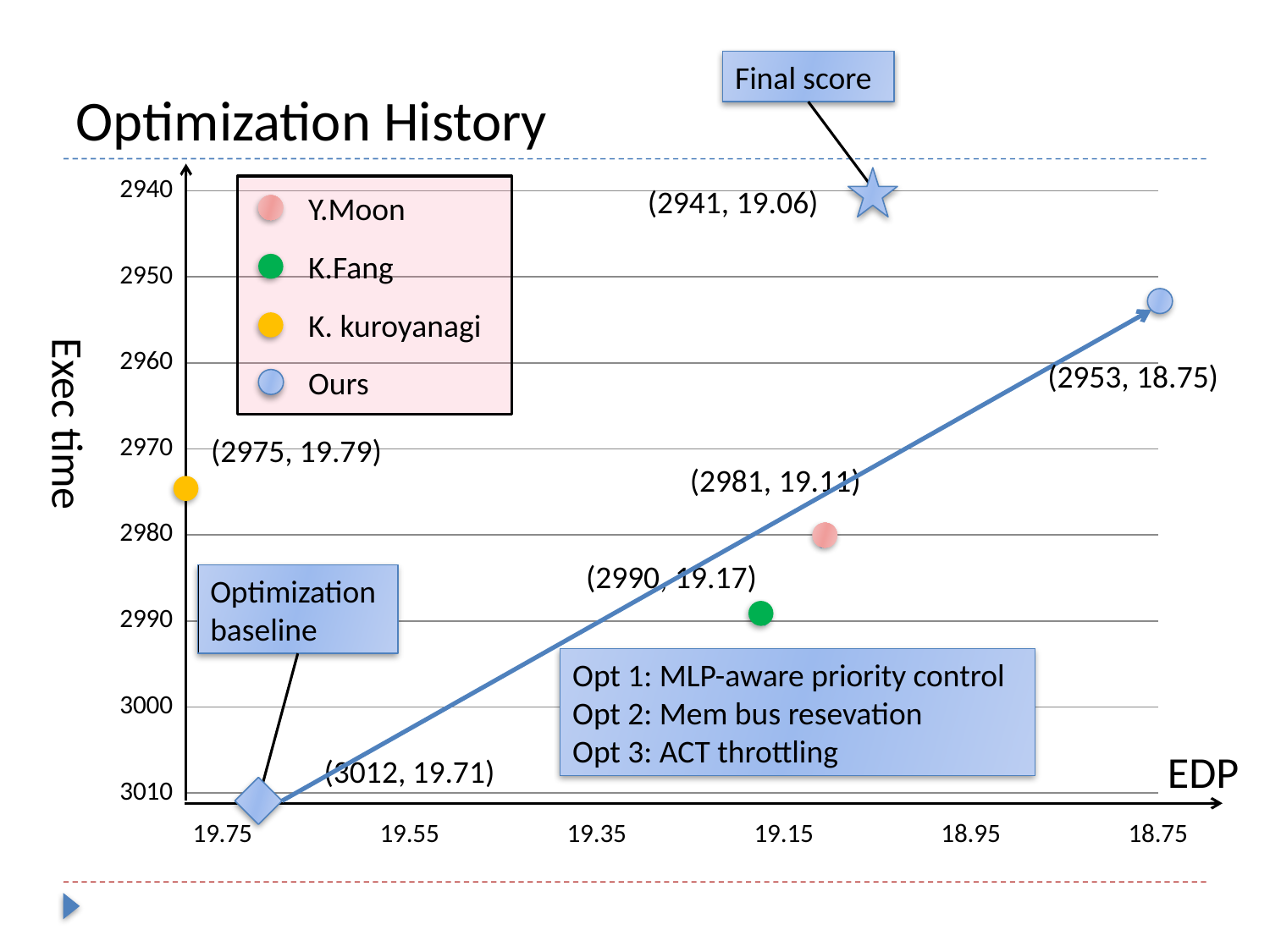
Which legend entry has the lowest exec time value among the four legend points? Ours What are the coordinates labelled for the Final score star? (2941, 19.06) What type of chart is shown on the slide? scatter chart Which has a higher exec time value, K.Fang or Y.Moon? K.Fang What is the title of the chart? Optimization History What is the difference in exec time between the Optimization baseline (3012) and the Ours point (2953)? 59 What are the coordinates labelled for the Y.Moon point? (2981, 19.11) How many entries does the chart legend list? 4 What are the coordinates labelled for the K.Fang point? (2990, 19.17) What are the coordinates labelled for the Optimization baseline point? (3012, 19.71) What are the coordinates labelled for the K. kuroyanagi point? (2975, 19.79) What are the coordinates labelled for the Ours point? (2953, 18.75)